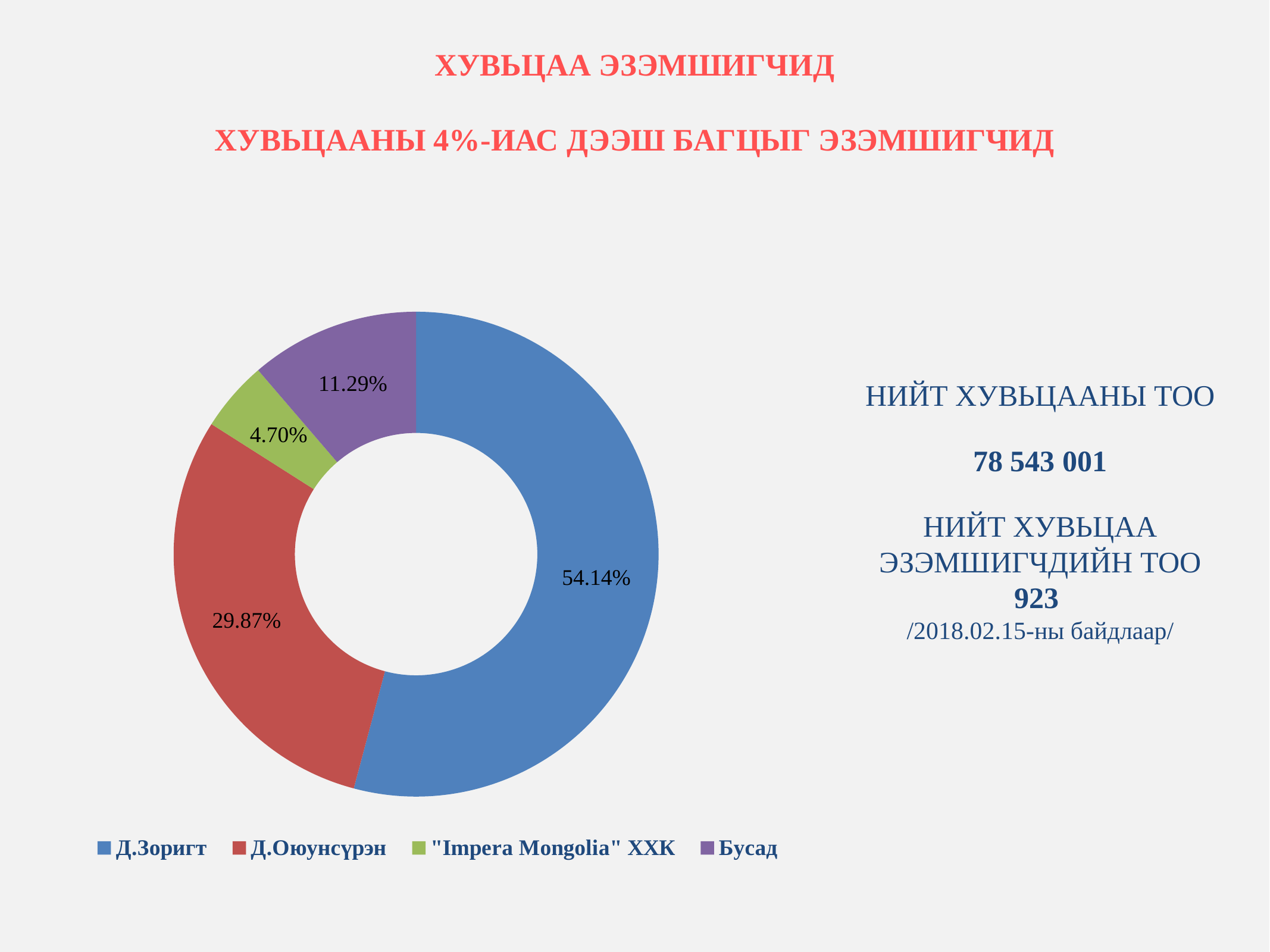
What share of the doughnut chart does "Impera Mongolia" ХХК hold? 4.70% What is the difference in percentage points between the shares of Д.Зоригт and Д.Оюунсүрэн? 24.27 What share of the doughnut chart does Д.Оюунсүрэн hold? 29.87% What colour is the slice for Д.Оюунсүрэн? Red What is the combined share of Д.Зоригт and Д.Оюунсүрэн? 84.01% How many categories does the chart show? 4 What share of the doughnut chart does Бусад hold? 11.29% Which category has the smallest share in the chart? "Impera Mongolia" ХХК What kind of chart is shown on the slide? Doughnut chart Which category has the largest share in the chart? Д.Зоригт Which has a larger share, Бусад or "Impera Mongolia" ХХК? Бусад What share of the doughnut chart does Д.Зоригт hold? 54.14%